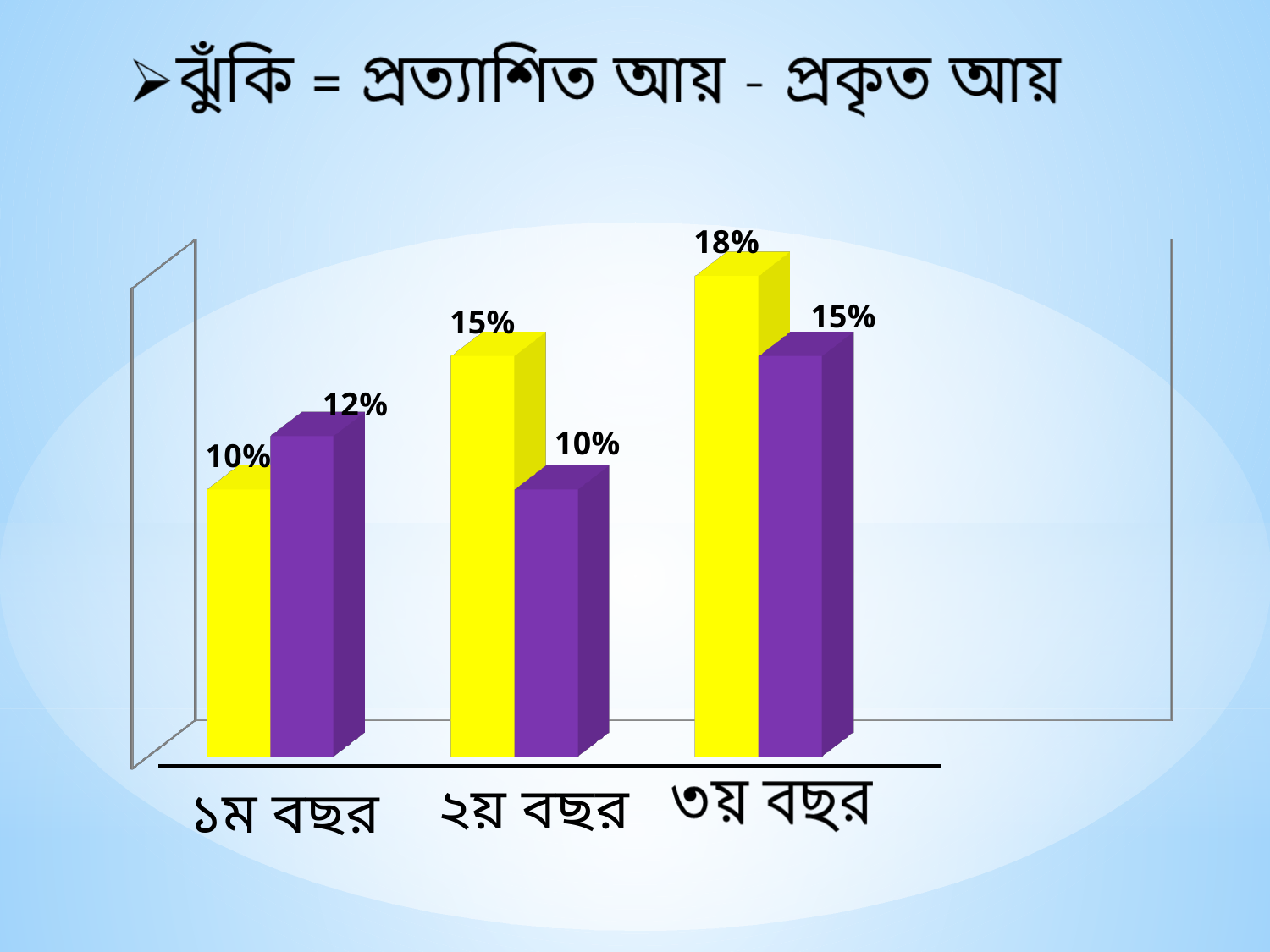
For ১ম বছর, which bar is larger, the yellow or the purple? purple What is the difference between the yellow and purple bars for ৩য় বছর? 3% What kind of chart is shown on the slide? bar chart What is the value of the purple bar for ১ম বছর? 12% Which category has the highest yellow bar? ৩য় বছর Do the yellow bars rise or fall from ১ম বছর to ৩য় বছর? rise What is the value of the yellow bar for ১ম বছর? 10% Which category has the lowest purple bar? ২য় বছর What is the value of the purple bar for ২য় বছর? 10% What is the value of the yellow bar for ৩য় বছর? 18% How many categories are shown on the x axis? 3 What two colours are used for the bars in the chart? yellow and purple